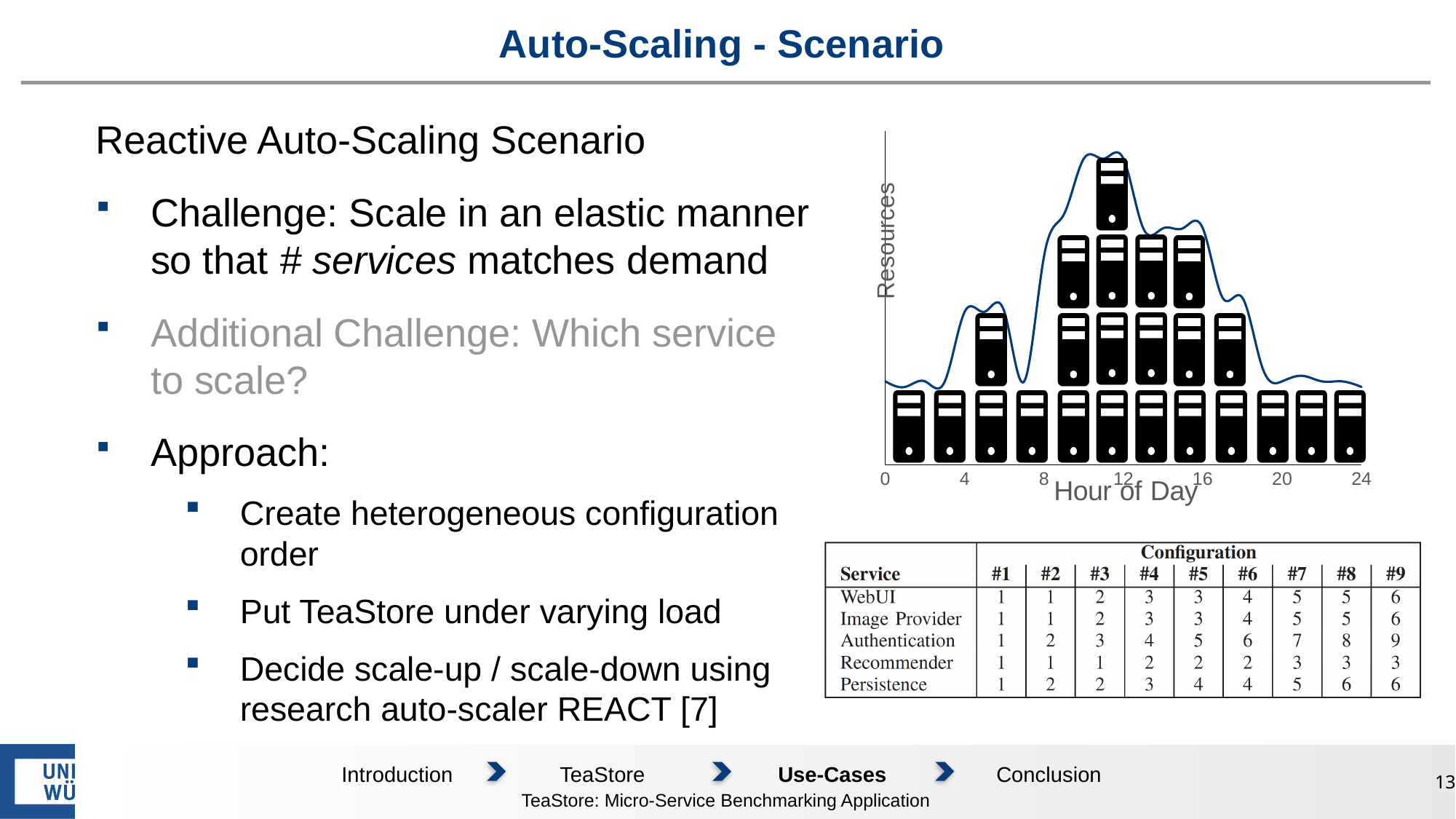
What is the label of the y axis of the chart? Resources What is the largest tick value shown on the x axis? 24 Does the resource demand line rise or fall between hour 8 and hour 12? rise Does the resource demand line rise or fall between hour 12 and hour 20? fall How many columns of server icons are drawn along the x axis? 12 What kind of chart is shown on the right of the slide? line chart What is the maximum number of server icons stacked in a single column of the chart? 4 Is the resource demand at hour 12 greater or less than the demand at hour 20? greater How many tick values are printed on the x axis of the chart? 7 What is the label of the x axis of the chart? Hour of Day Is the resource demand at hour 0 greater or less than the demand at hour 12? less